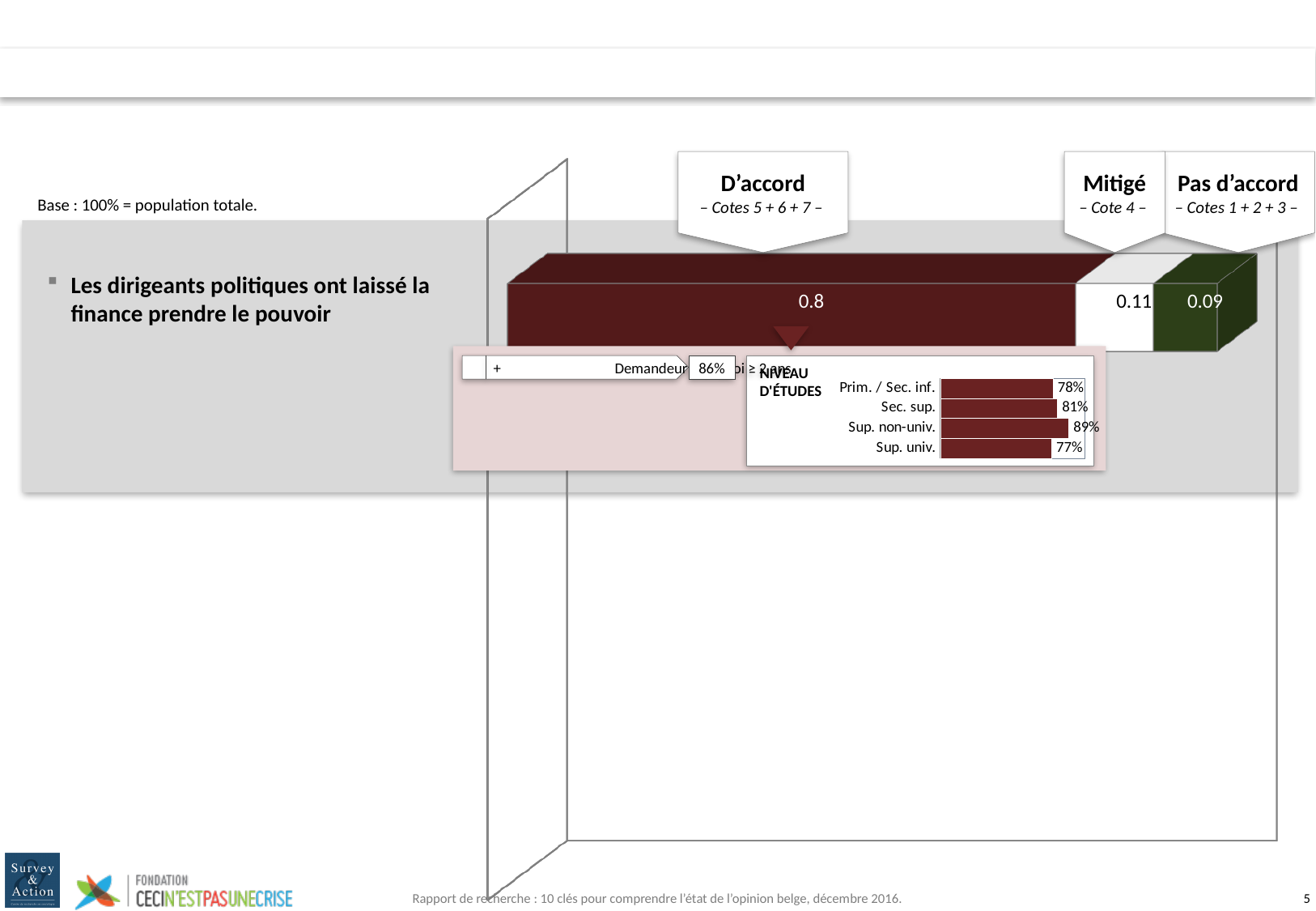
In the NIVEAU D'ÉTUDES chart, how many categories are shown? 4 In the main stacked bar chart, what is the difference between the D'accord and Mitigé values? 0.69 In the main stacked bar chart, which segment is the largest? D'accord In the main stacked bar chart, what is the value for the D'accord segment? 0.8 In the main stacked bar chart, what is the value for the Pas d'accord segment? 0.09 In the main stacked bar chart, which segment is the smallest? Pas d'accord In the NIVEAU D'ÉTUDES chart, which category has the lowest value? Sup. univ. In the main stacked bar chart, what is the total of the three segments? 1 In the NIVEAU D'ÉTUDES chart, what is the difference between Sup. non-univ. and Prim. / Sec. inf.? 11% In the main stacked bar chart, what is the value for the Mitigé segment? 0.11 In the NIVEAU D'ÉTUDES chart, what is the value for Sec. sup.? 81% In the NIVEAU D'ÉTUDES chart, what is the value for Sup. non-univ.? 89%